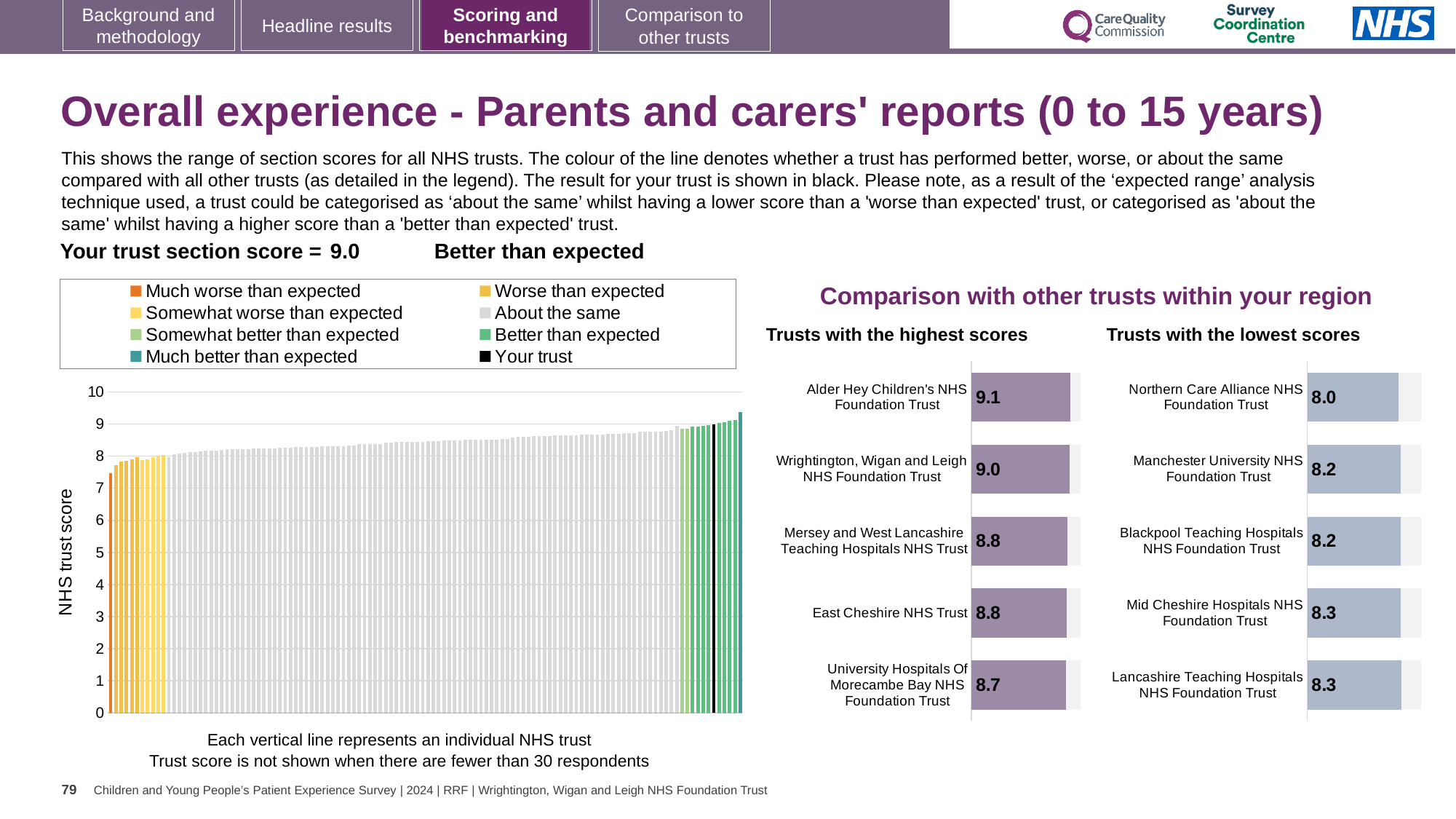
How many trusts are shown in the 'Trusts with the highest scores' chart? 5 What is the y-axis label of the main chart on the left of the slide? NHS trust score In the 'Trusts with the highest scores' chart, which trust has the highest score? Alder Hey Children's NHS Foundation Trust In the 'Trusts with the lowest scores' chart, which has the larger score: Mid Cheshire Hospitals NHS Foundation Trust or Manchester University NHS Foundation Trust? Mid Cheshire Hospitals NHS Foundation Trust In the 'Trusts with the lowest scores' chart, what is the score for Northern Care Alliance NHS Foundation Trust? 8.0 In the 'Trusts with the highest scores' chart, what is the difference between the scores of Alder Hey Children's NHS Foundation Trust and University Hospitals Of Morecambe Bay NHS Foundation Trust? 0.4 In the 'Trusts with the lowest scores' chart, what is the difference between the scores of Lancashire Teaching Hospitals NHS Foundation Trust and Northern Care Alliance NHS Foundation Trust? 0.3 In the 'Trusts with the lowest scores' chart, which trust has the lowest score? Northern Care Alliance NHS Foundation Trust In the main 'NHS trust score' chart, is the value for your trust (the black bar) greater or less than 8? greater How many entries does the legend of the main 'NHS trust score' chart list? 8 What kind of chart is the 'Trusts with the lowest scores' chart? Bar chart In the 'Trusts with the highest scores' chart, what is the score for Alder Hey Children's NHS Foundation Trust? 9.1